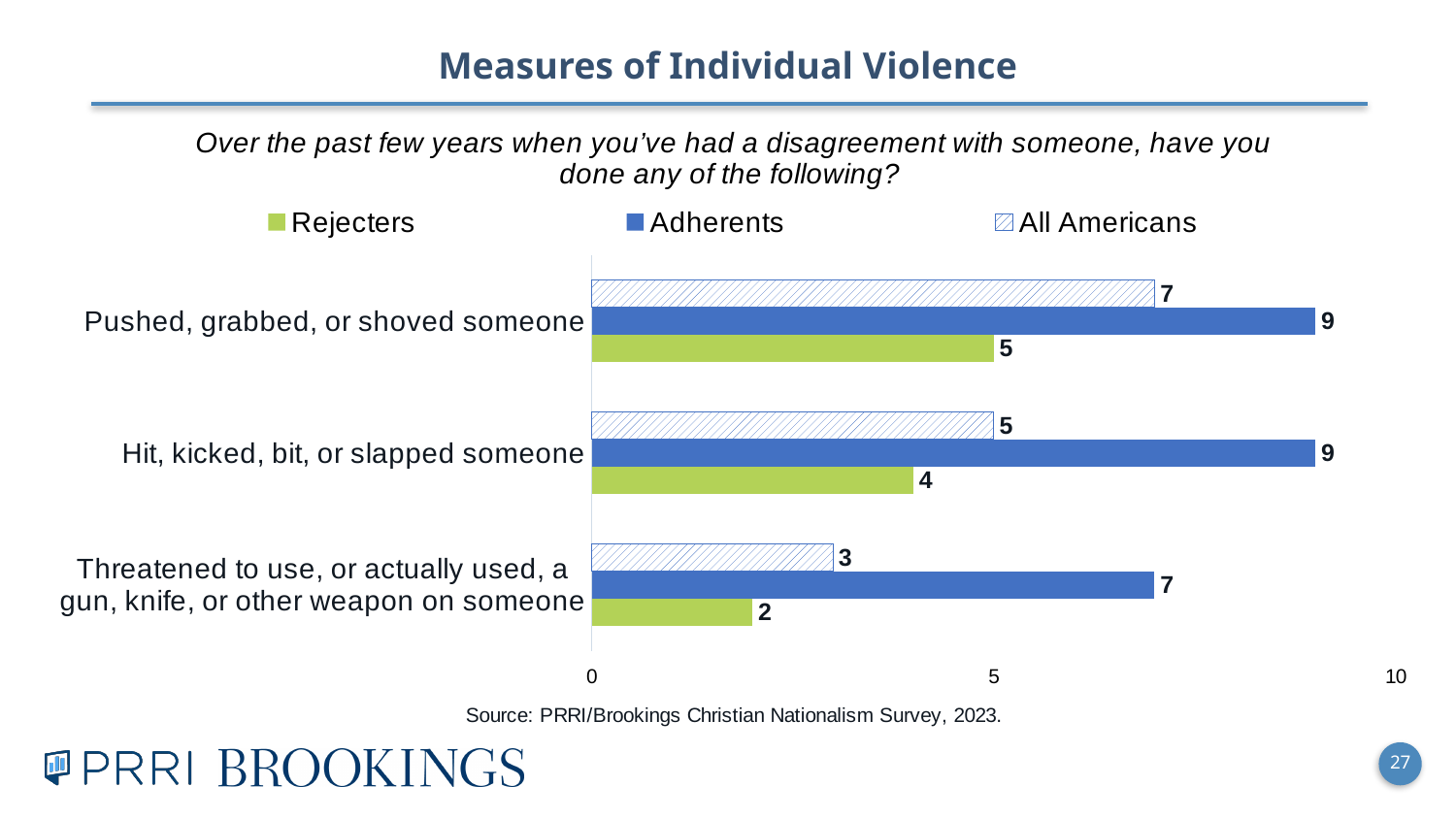
Which category has the lowest value for All Americans? Threatened to use, or actually used, a gun, knife, or other weapon on someone Which is larger for "Hit, kicked, bit, or slapped someone": the Rejecters value or the All Americans value? All Americans What is the difference between the All Americans and Rejecters values for "Threatened to use, or actually used, a gun, knife, or other weapon on someone"? 1 What is the value for Rejecters for "Threatened to use, or actually used, a gun, knife, or other weapon on someone"? 2 What is the value for Adherents for "Pushed, grabbed, or shoved someone"? 9 How many series does the legend list? 3 Which series has the highest value for "Hit, kicked, bit, or slapped someone"? Adherents What kind of chart is shown on the slide? Bar chart How many categories are shown on the chart? 3 What is the difference between the Adherents and Rejecters values for "Pushed, grabbed, or shoved someone"? 4 What is the title of the chart? Measures of Individual Violence What is the value for All Americans for "Hit, kicked, bit, or slapped someone"? 5